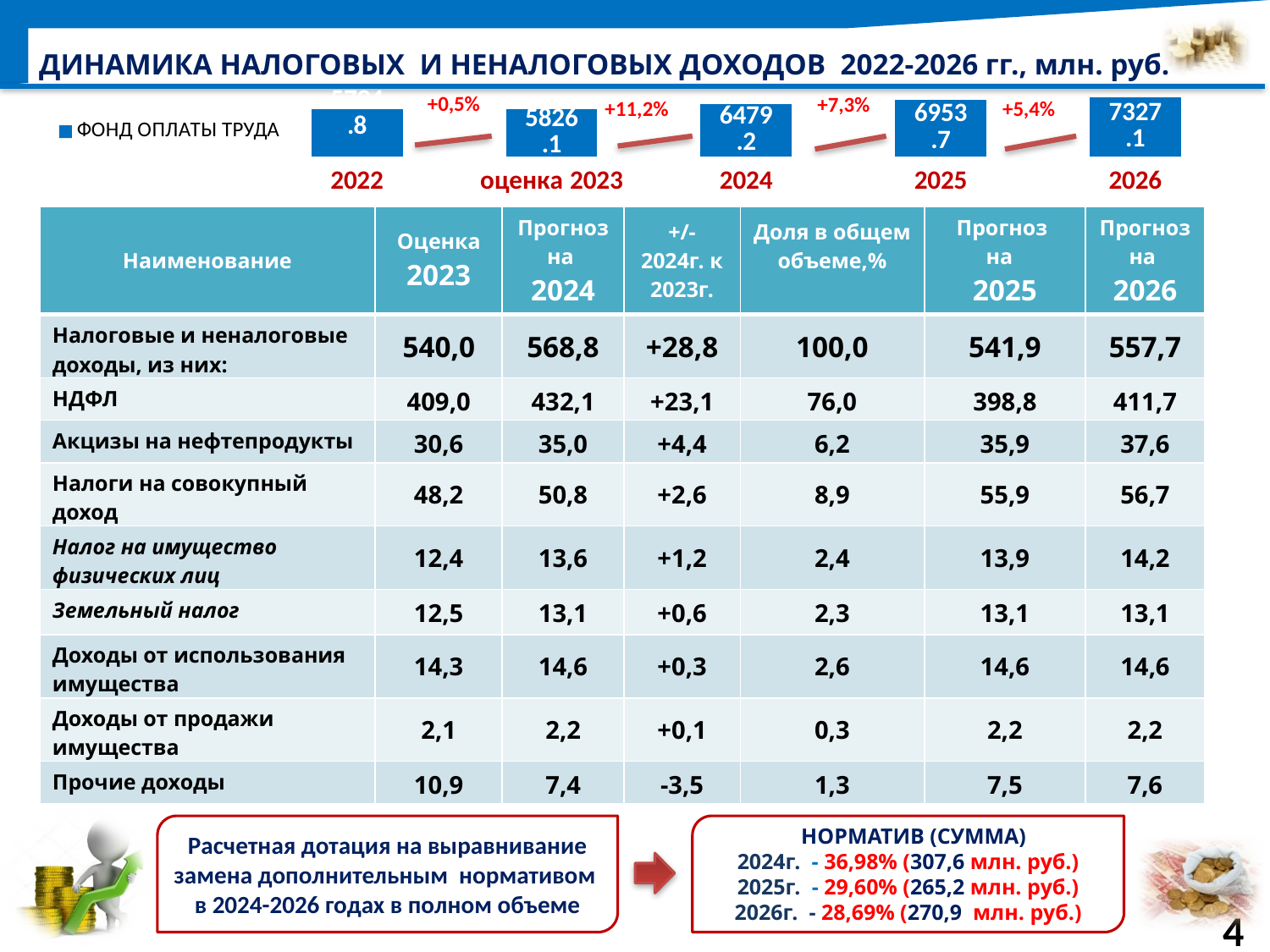
In the ФОНД ОПЛАТЫ ТРУДА chart, what is the value for оценка 2023? 5826.1 In the ФОНД ОПЛАТЫ ТРУДА chart, do the values rise or fall from 2022 to 2026? rise In the ФОНД ОПЛАТЫ ТРУДА chart, what is the value for 2026? 7327.1 What kind of chart is the ФОНД ОПЛАТЫ ТРУДА chart? bar chart In the ФОНД ОПЛАТЫ ТРУДА chart, which year has the highest value? 2026 In the ФОНД ОПЛАТЫ ТРУДА chart, what is the value for 2024? 6479.2 In the ФОНД ОПЛАТЫ ТРУДА chart, what growth percentage is shown between оценка 2023 and 2024? +11,2% In the ФОНД ОПЛАТЫ ТРУДА chart, what is the difference between the 2024 value and the оценка 2023 value? 653.1 In the ФОНД ОПЛАТЫ ТРУДА chart, what is the value for 2025? 6953.7 In the ФОНД ОПЛАТЫ ТРУДА chart, which is larger, the value for 2025 or the value for 2024? 2025 In the ФОНД ОПЛАТЫ ТРУДА chart, what is the difference between the 2026 and 2025 values? 373.4 How many periods are shown on the x axis of the ФОНД ОПЛАТЫ ТРУДА chart? 5